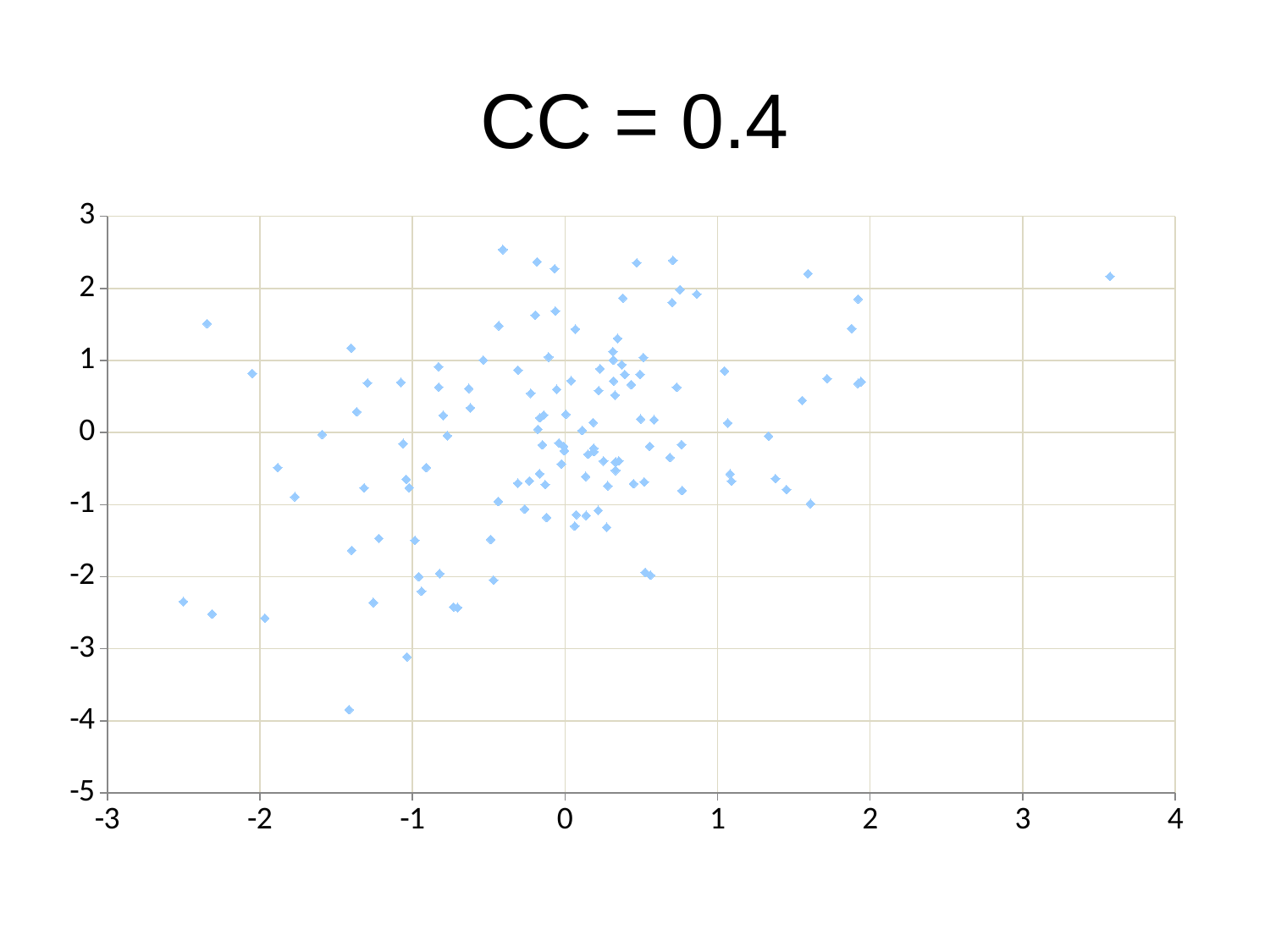
Is the y value of the lowest point on the chart greater or less than -3? less What is the maximum value shown on the x axis? 4 Is the y value of the rightmost point on the chart greater or less than 1? greater Is the x value of the rightmost point on the chart greater or less than 3? greater What kind of chart is shown on the slide? scatter plot What is the minimum value shown on the y axis? -5 What is the title of the chart? CC = 0.4 Do the y values generally rise or fall as x increases across the chart? rise